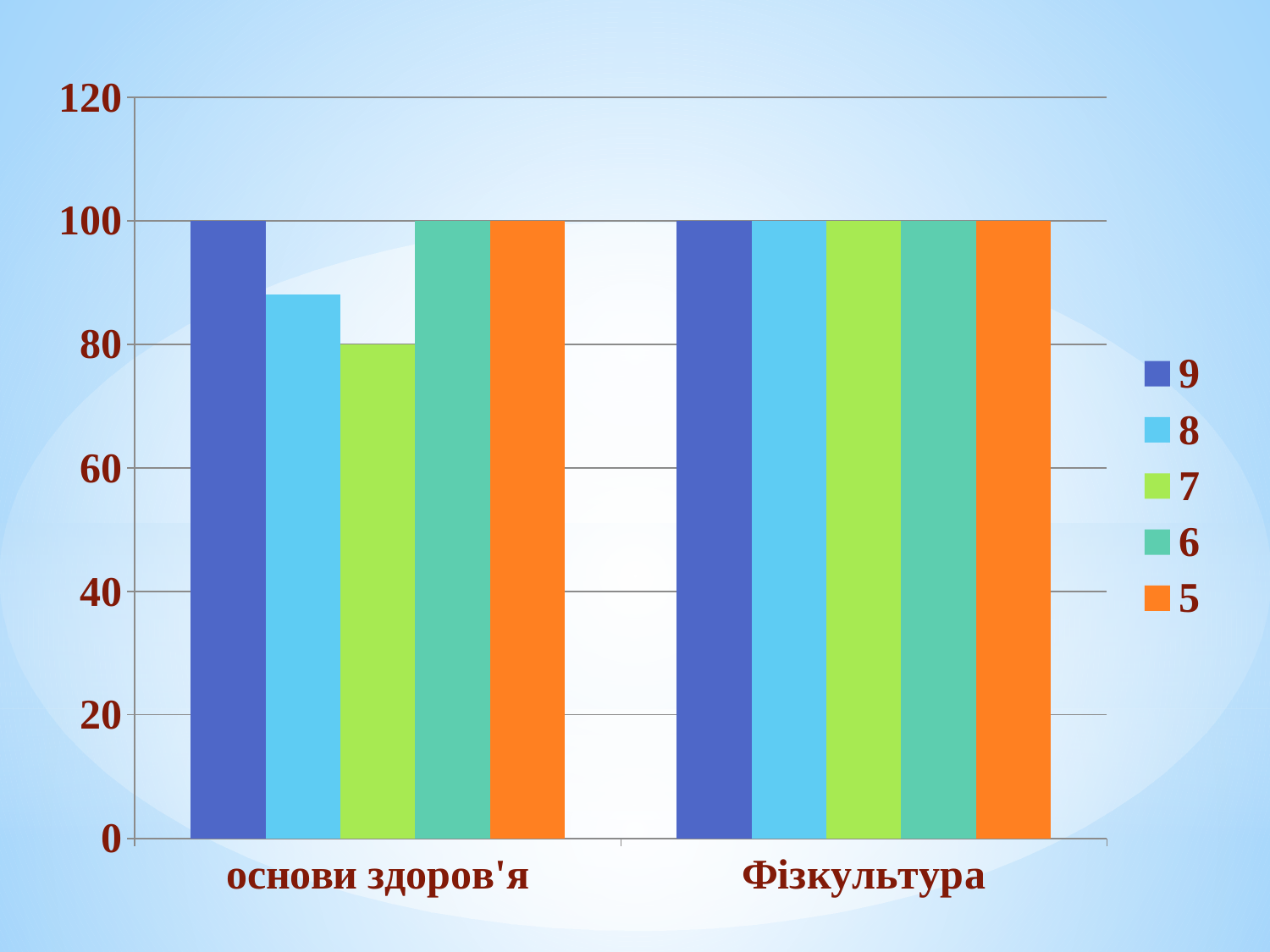
What is the value for series 9 in the category основи здоров'я? 100 Which legend entry is shown in orange? 5 What is the value for series 7 in the category основи здоров'я? 80 Which is larger in the category основи здоров'я: the value for series 8 or the value for series 7? series 8 How many categories are shown on the x axis? 2 Is the value for series 8 in the category основи здоров'я greater or less than 100? less Which series has the lowest value in the category основи здоров'я? 7 Is the value for series 8 in the category основи здоров'я greater or less than 80? greater How many series does the legend list? 5 What is the value for series 5 in the category Фізкультура? 100 What is the difference between the value for series 9 and the value for series 7 in the category основи здоров'я? 20 What kind of chart is shown on the slide? bar chart